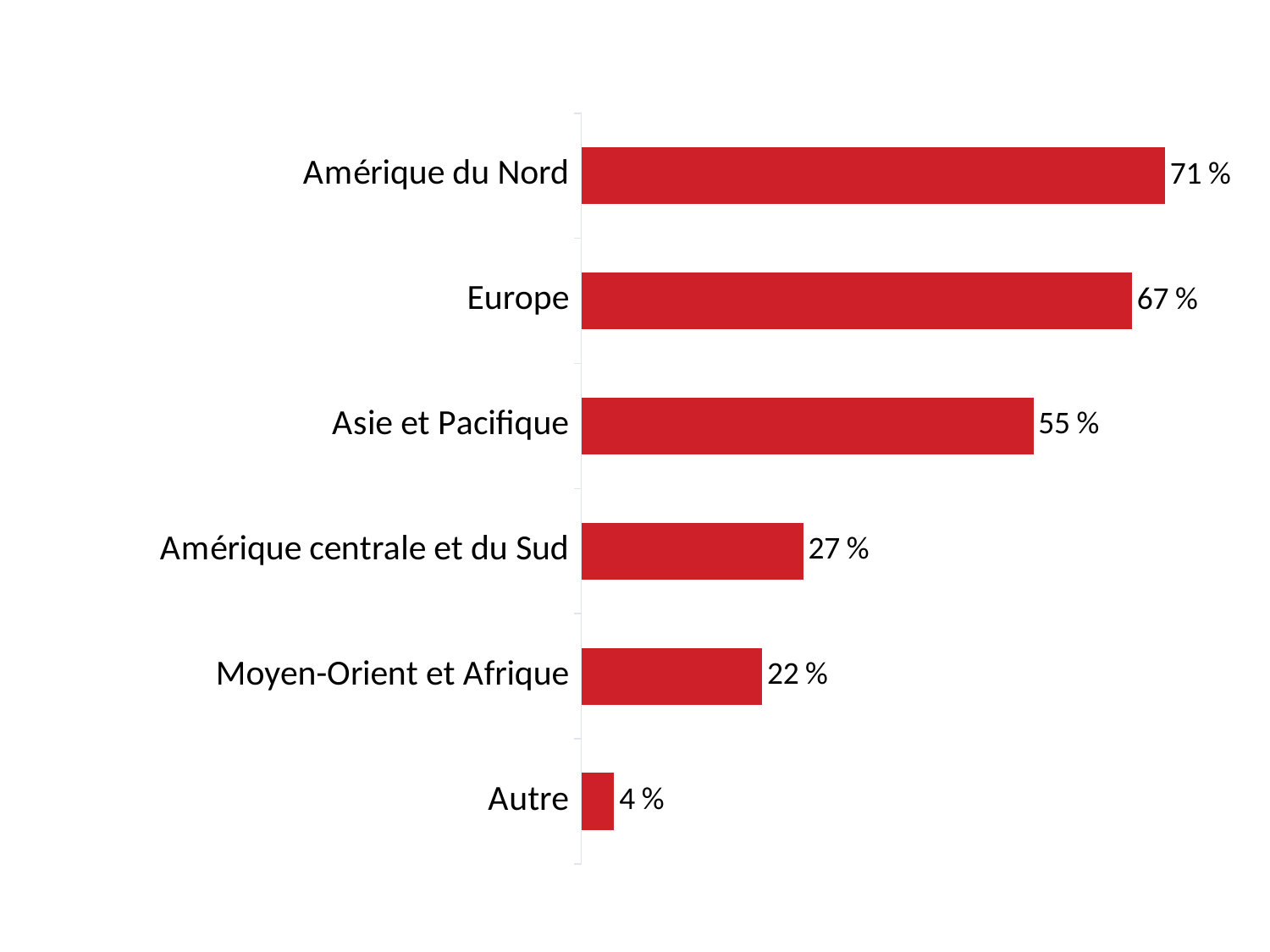
What is the difference between the values for Amérique du Nord and Europe? 4 % Which is larger, the value for Asie et Pacifique or the value for Amérique centrale et du Sud? Asie et Pacifique What is the value for Moyen-Orient et Afrique? 22 % Which category has the lowest value? Autre What is the value for Amérique du Nord? 71 % What is the value for Asie et Pacifique? 55 % What is the value for Amérique centrale et du Sud? 27 % How many categories are shown in the chart? 6 What is the value for Europe? 67 % What is the value for Autre? 4 % What kind of chart is shown on the slide? Bar chart Which category has the highest value? Amérique du Nord